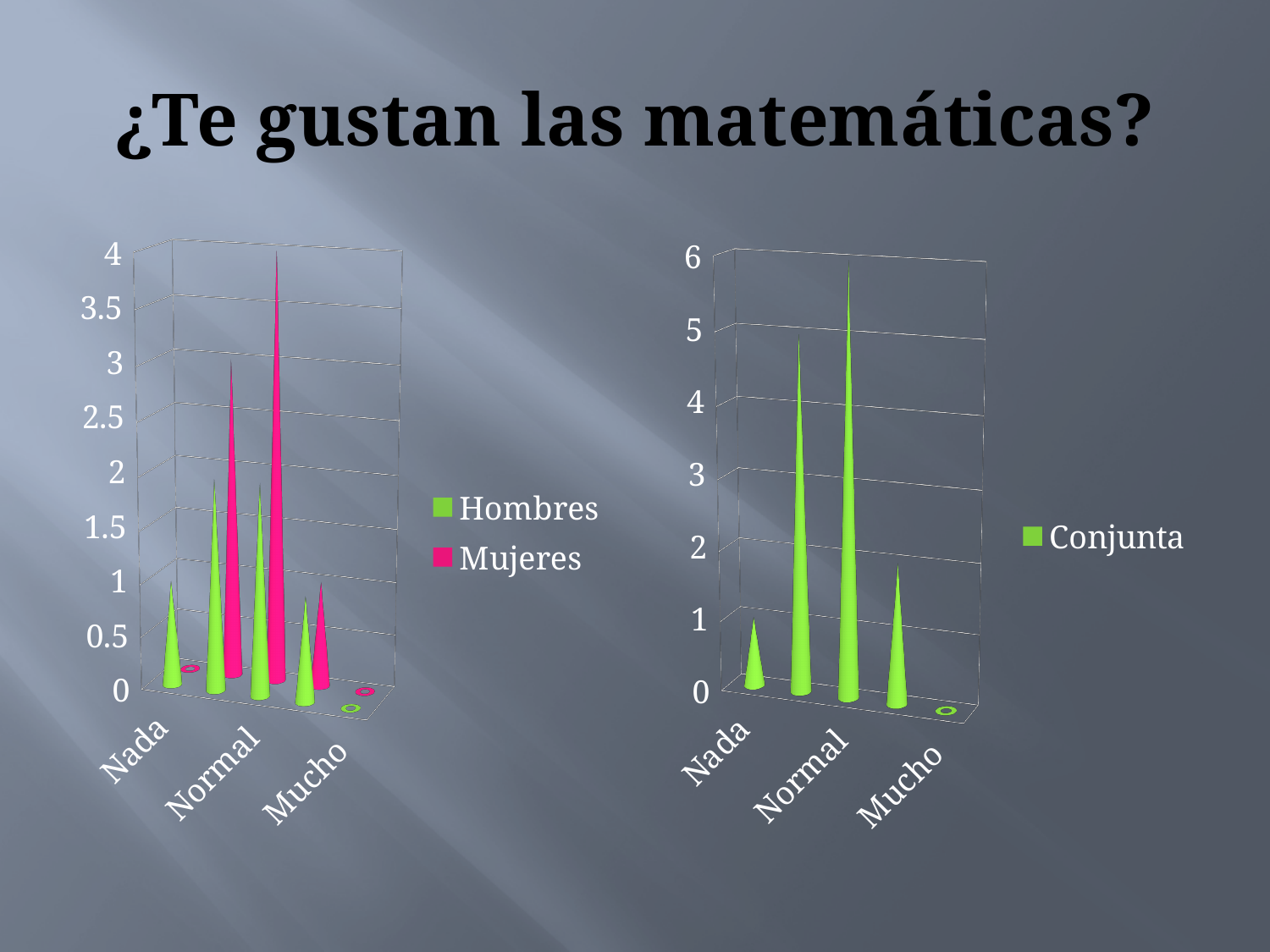
In the right chart, is the Conjunta value for Nada greater or less than 3? less What is the legend entry of the right chart? Conjunta In the left chart, is the tallest Mujeres value greater or less than 3? greater What are the legend entries of the left chart? Hombres, Mujeres In the left chart, which series has the tallest bar? Mujeres How many series does the legend of the right chart list? 1 What is the highest value shown on the vertical axis of the right chart? 6 What kind of chart is the right chart on the slide? bar chart In the right chart, is the tallest Conjunta value greater or less than 4? greater What kind of chart is the left chart on the slide? bar chart How many series does the legend of the left chart list? 2